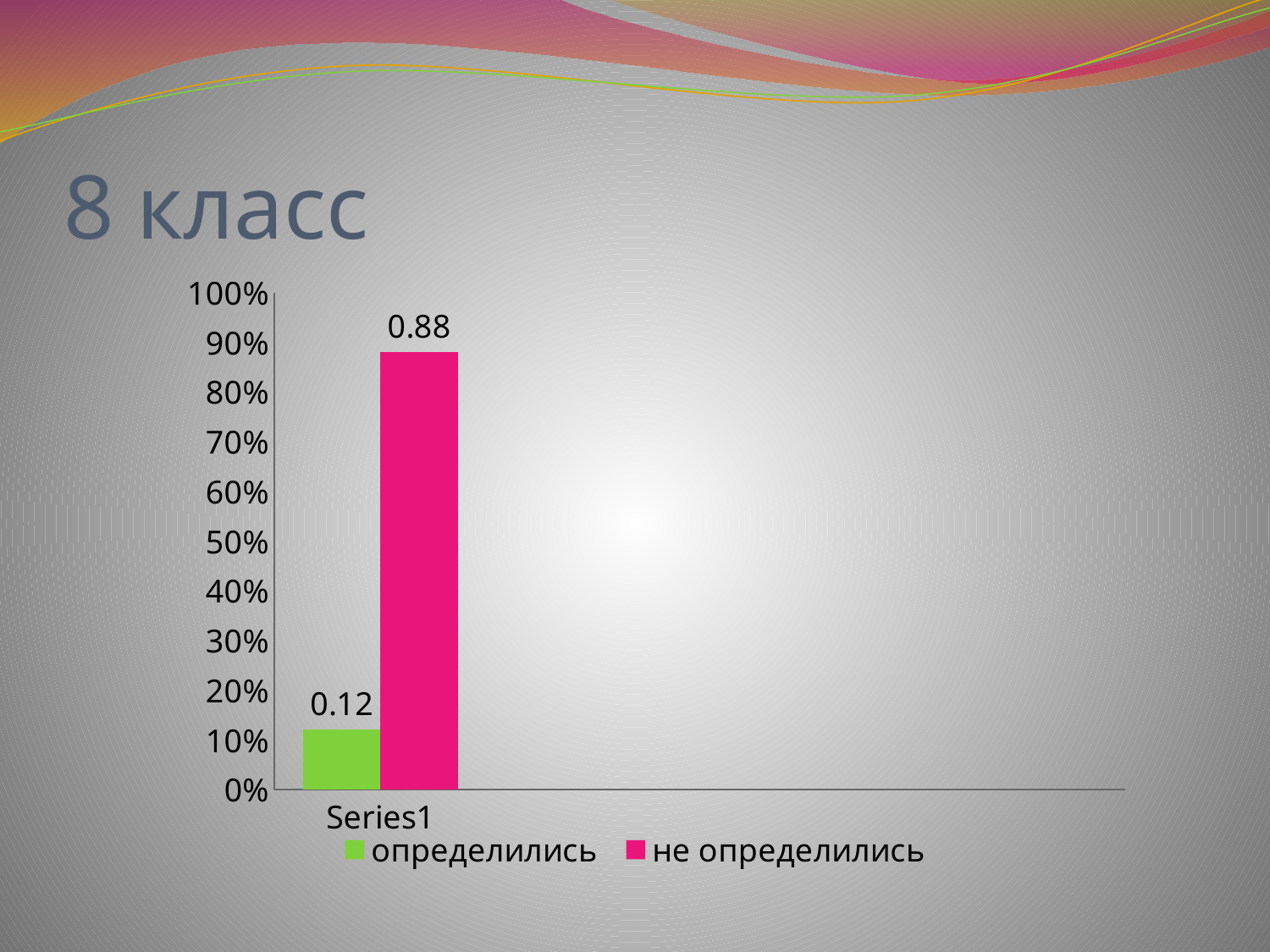
What is the value for the series "не определились"? 0.88 What is the difference between the values for "не определились" and "определились"? 0.76 What colour is the bar for "не определились"? pink Which series has the lower value? определились Is the value for "определились" larger or smaller than the value for "не определились"? smaller What is the value for the series "определились"? 0.12 Is the bar for "не определились" greater or less than 80%? greater How many series does the legend list? 2 What kind of chart is shown on the slide? bar chart What is the category label shown on the x axis? Series1 Which series has the higher value? не определились Is the bar for "определились" greater or less than 20%? less